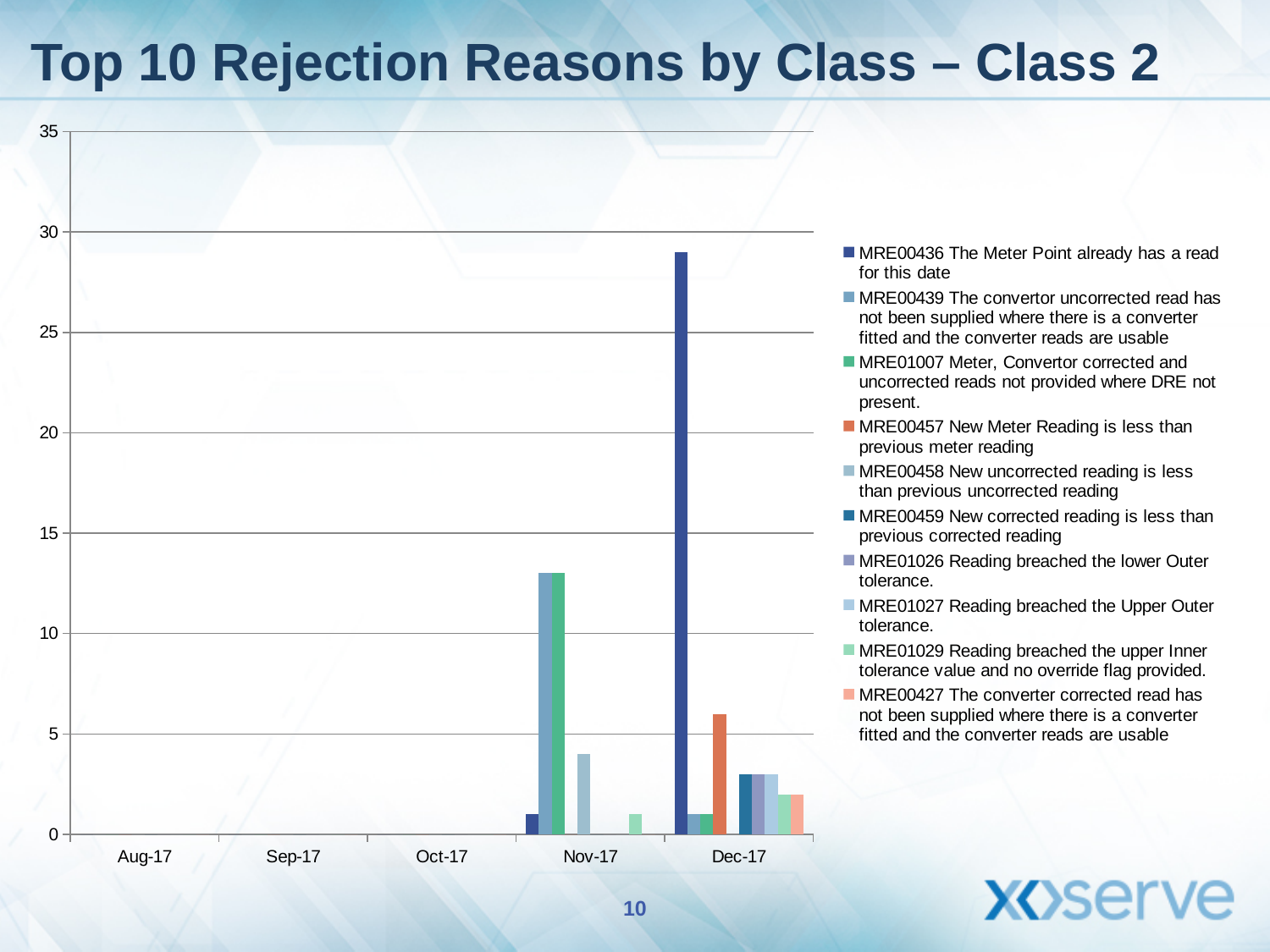
Which month has the tallest bar in the chart? Dec-17 What kind of chart is shown on the slide? bar chart What is the title of the slide? Top 10 Rejection Reasons by Class – Class 2 Is the value for MRE00436 in Dec-17 greater or less than 30? less How many series does the legend list? 10 Is the value for MRE00436 in Dec-17 greater or less than 25? greater Which series has the tallest bar in Dec-17? MRE00436 The Meter Point already has a read for this date Is the value for MRE00439 in Nov-17 greater or less than 10? greater How many months are shown on the x axis of the chart? 5 Which is larger: the value for MRE00436 in Dec-17 or the value for MRE00439 in Nov-17? MRE00436 in Dec-17